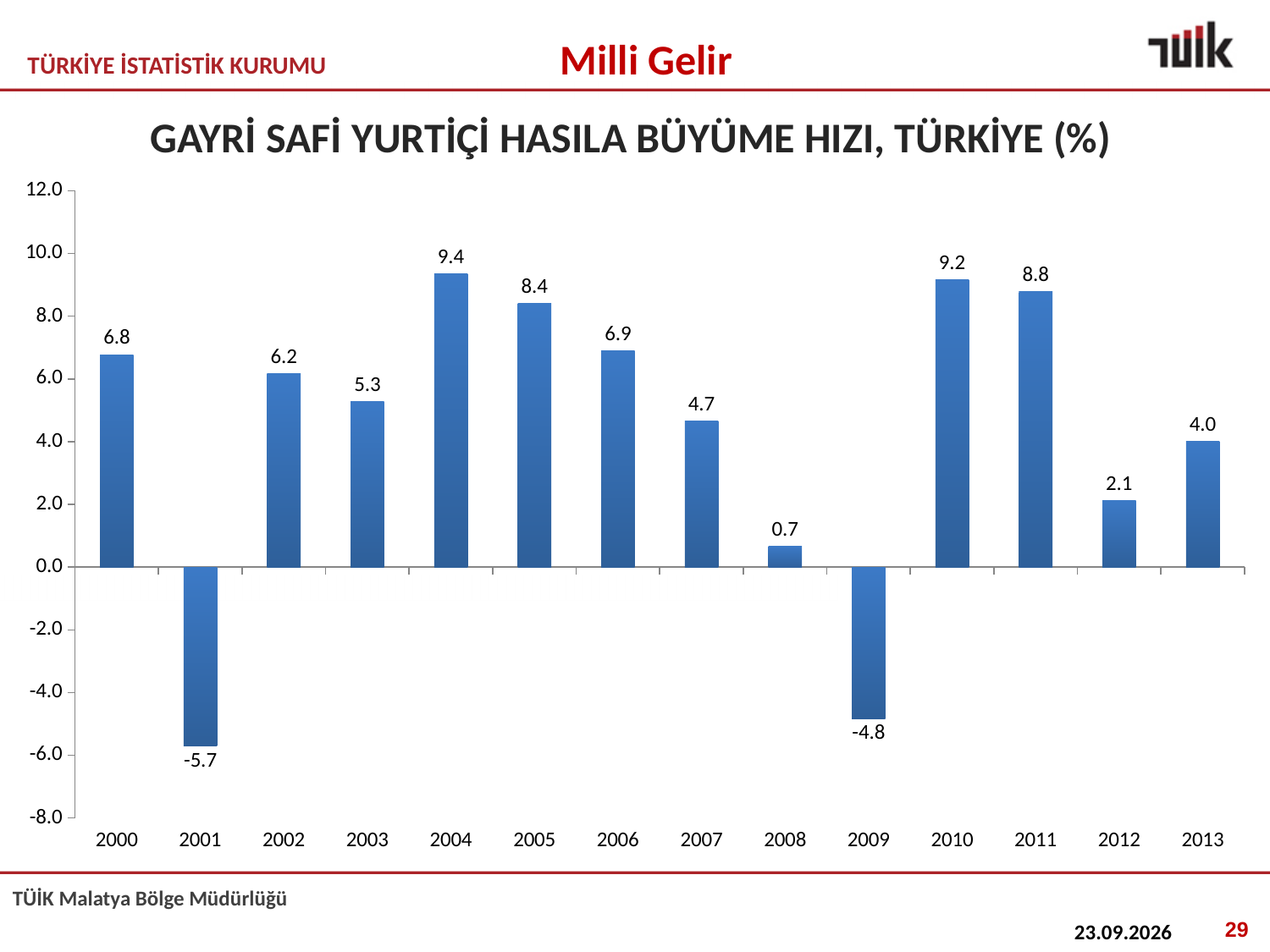
What is the difference between the values for 2010 and 2011? 0.4 Which year has a larger value, 2002 or 2006? 2006 What is the title of the chart? GAYRİ SAFİ YURTİÇİ HASILA BÜYÜME HIZI, TÜRKİYE (%) What is the value shown for 2009? -4.8 Which year has the highest growth rate? 2004 How many years are shown on the x axis? 14 Which year has the lowest growth rate? 2001 Is the value for 2005 greater or less than 8.0? greater What is the GDP growth rate shown for 2004? 9.4 What is the value shown for 2013? 4.0 What is the difference between the values for 2004 and 2012? 7.3 What kind of chart is shown on the slide? bar chart